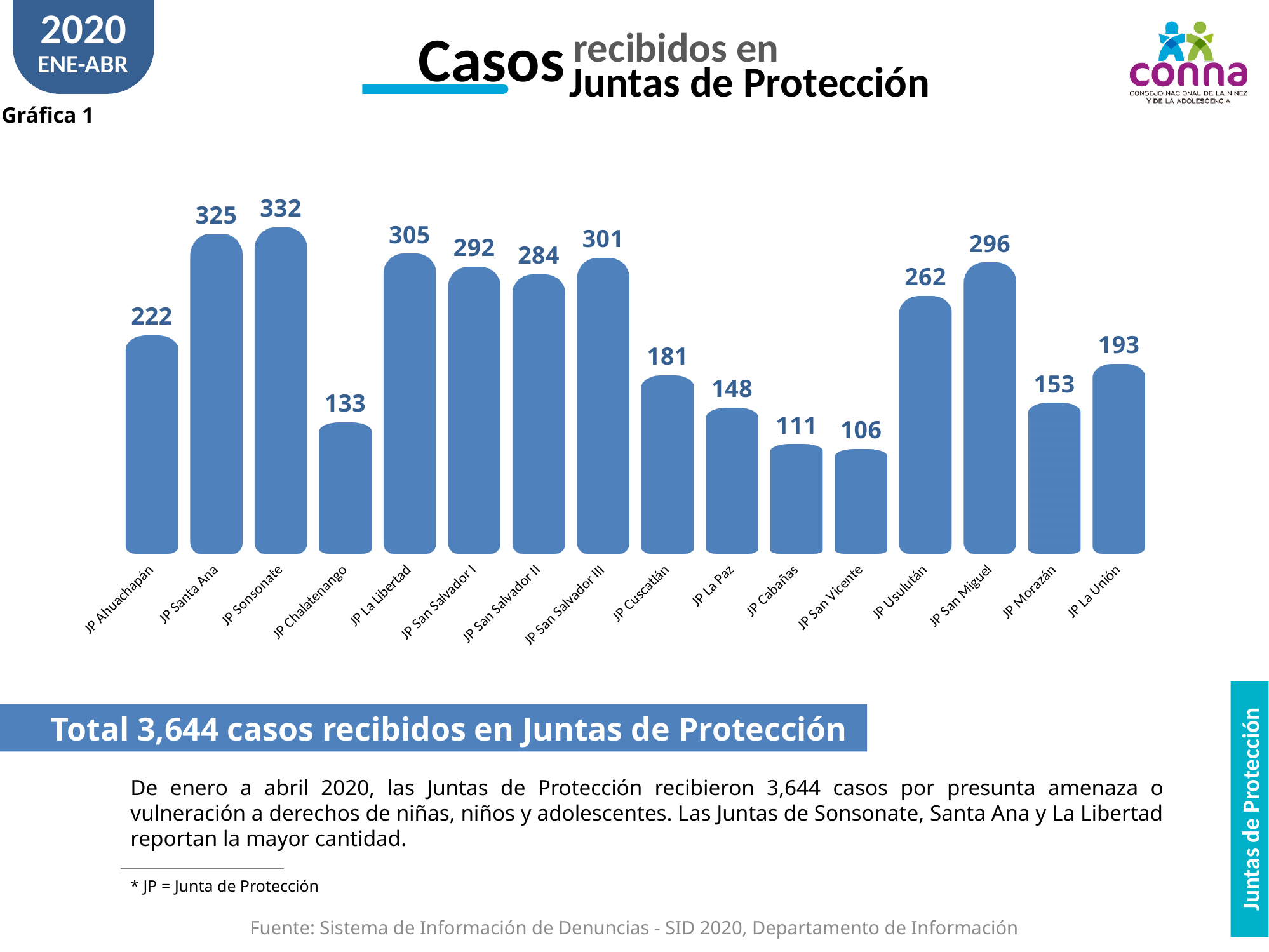
Which Junta de Protección has the lowest number of cases? JP San Vicente How many Juntas de Protección are shown on the chart? 16 Which has more cases, JP La Libertad or JP San Salvador III? JP La Libertad Which Junta de Protección has the highest number of cases? JP Sonsonate What total number of cases received in Juntas de Protección is stated on the slide? 3,644 How many cases were received by JP Sonsonate? 332 Which has fewer cases, JP La Paz or JP Morazán? JP La Paz What is the difference between the cases for JP San Miguel and JP Usulután? 34 What is the difference between the cases for JP Santa Ana and JP Chalatenango? 192 What type of chart is shown on the slide? Bar chart How many cases does the chart show for JP La Unión? 193 What is the value shown for JP Cuscatlán? 181